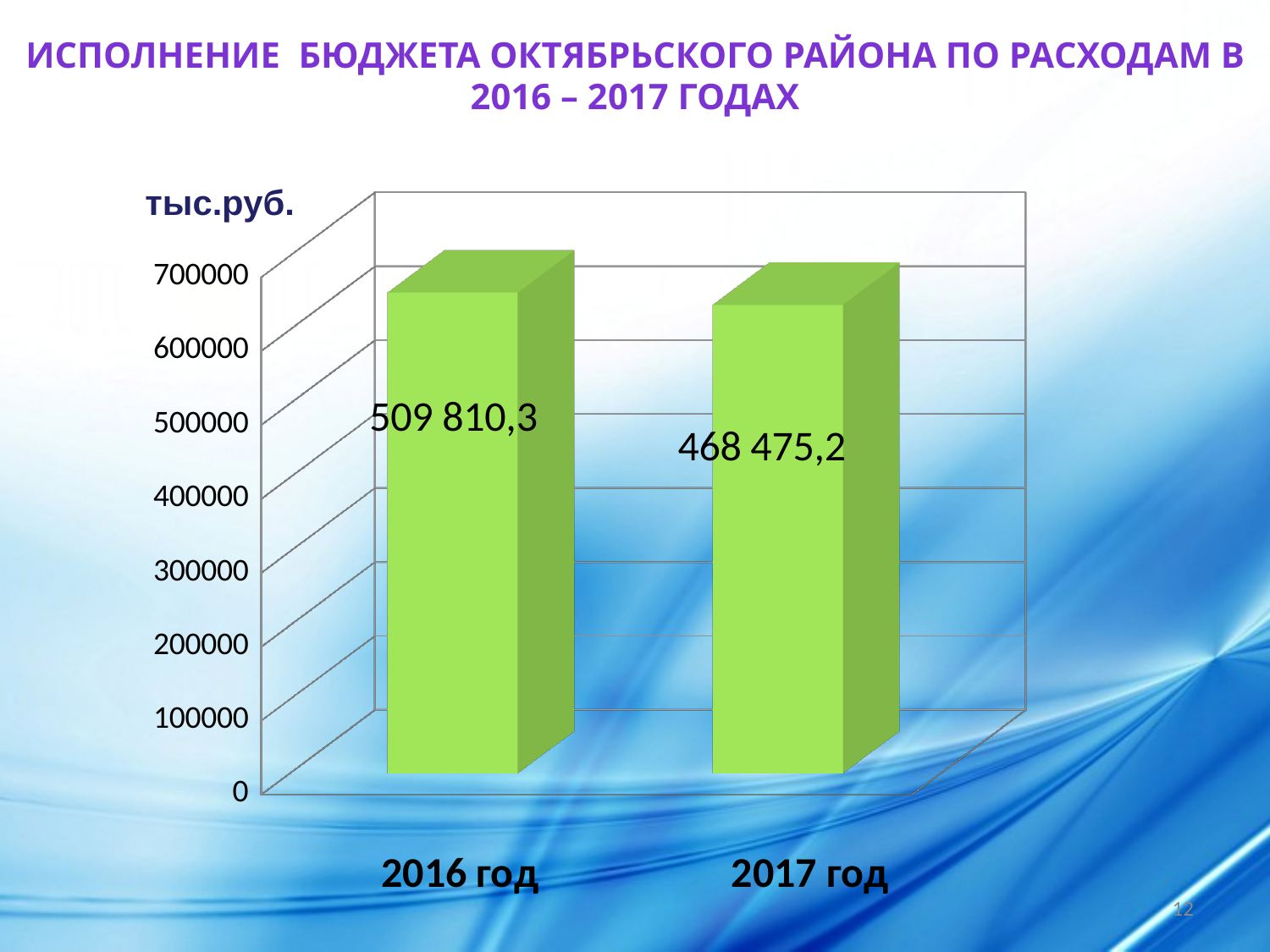
Which year has the highest value? 2016 год What kind of chart is shown on the slide? Bar chart What is the title of the slide? ИСПОЛНЕНИЕ БЮДЖЕТА ОКТЯБРЬСКОГО РАЙОНА ПО РАСХОДАМ В 2016 – 2017 ГОДАХ Is the value for 2017 год greater or less than 400000? greater Do the values rise or fall from 2016 год to 2017 год? Fall Which year has the lowest value? 2017 год What is the value for 2016 год? 509 810,3 Which is larger, the value for 2016 год or the value for 2017 год? 2016 год How many categories are shown on the chart? 2 What is the difference between the values for 2016 год and 2017 год? 41 335,1 What is the value for 2017 год? 468 475,2 What unit is shown for the values on the chart? тыс.руб.